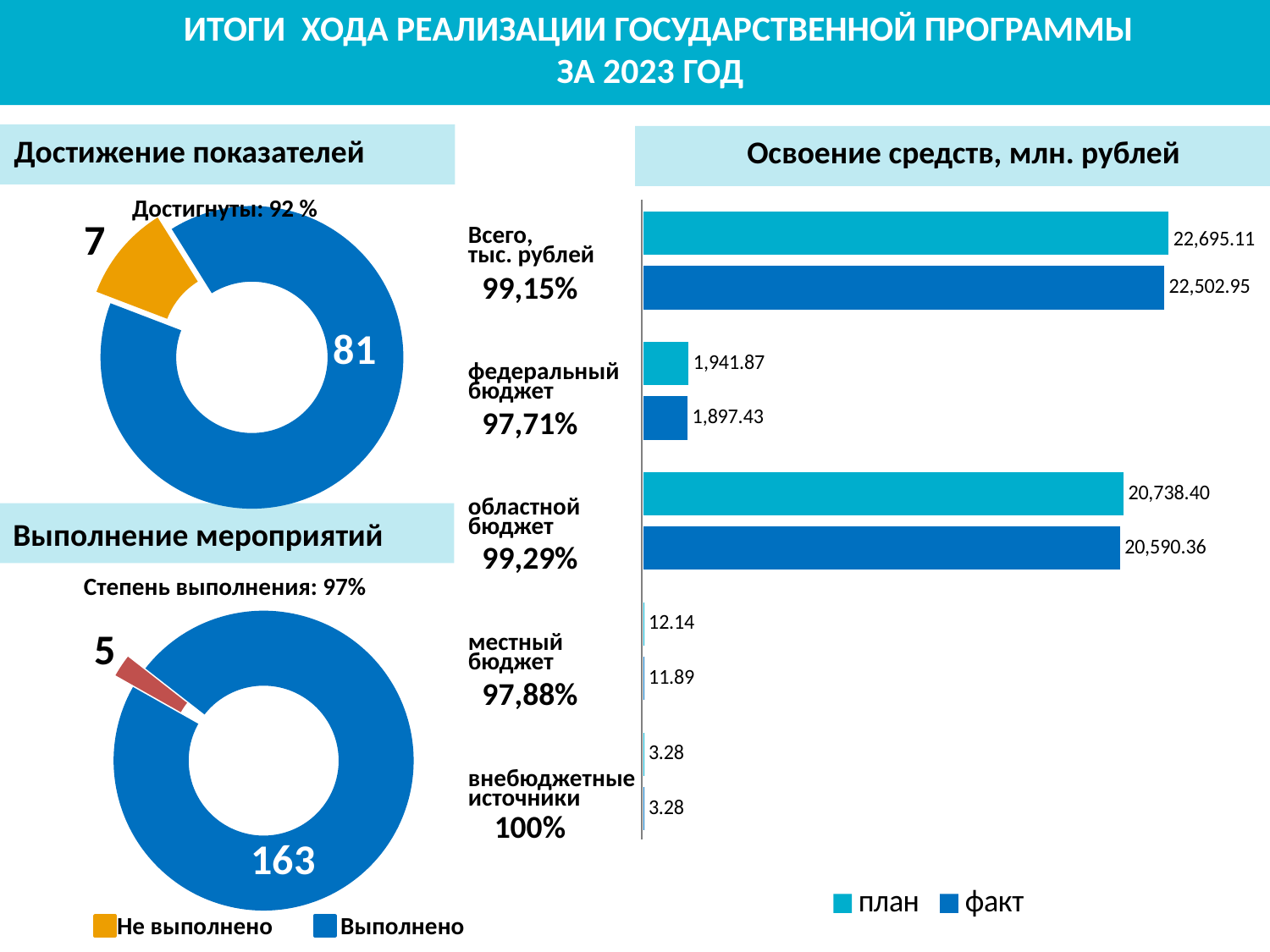
In the 'Освоение средств, млн. рублей' bar chart, which is larger for местный бюджет, план or факт? план In the 'Освоение средств, млн. рублей' bar chart, what is the difference between the план and факт values for федеральный бюджет? 44.44 How many categories are shown in the 'Освоение средств, млн. рублей' chart? 5 In the 'Освоение средств, млн. рублей' bar chart, what is the план value for федеральный бюджет? 1,941.87 In the 'Освоение средств, млн. рублей' bar chart, which category has the lowest план value? внебюджетные источники In the 'Освоение средств, млн. рублей' bar chart, what is the факт value for областной бюджет? 20,590.36 In the 'Достижение показателей' donut chart, how many indicators were achieved (Выполнено)? 81 In the 'Освоение средств, млн. рублей' bar chart, what is the difference between the план and факт values for 'Всего, тыс. рублей'? 192.16 What kind of chart is 'Освоение средств, млн. рублей'? bar chart In the 'Достижение показателей' donut chart, what is the total of the two segments? 88 In the 'Выполнение мероприятий' donut chart, how many activities were not completed (Не выполнено)? 5 How many series does the legend of the 'Освоение средств, млн. рублей' chart list? 2